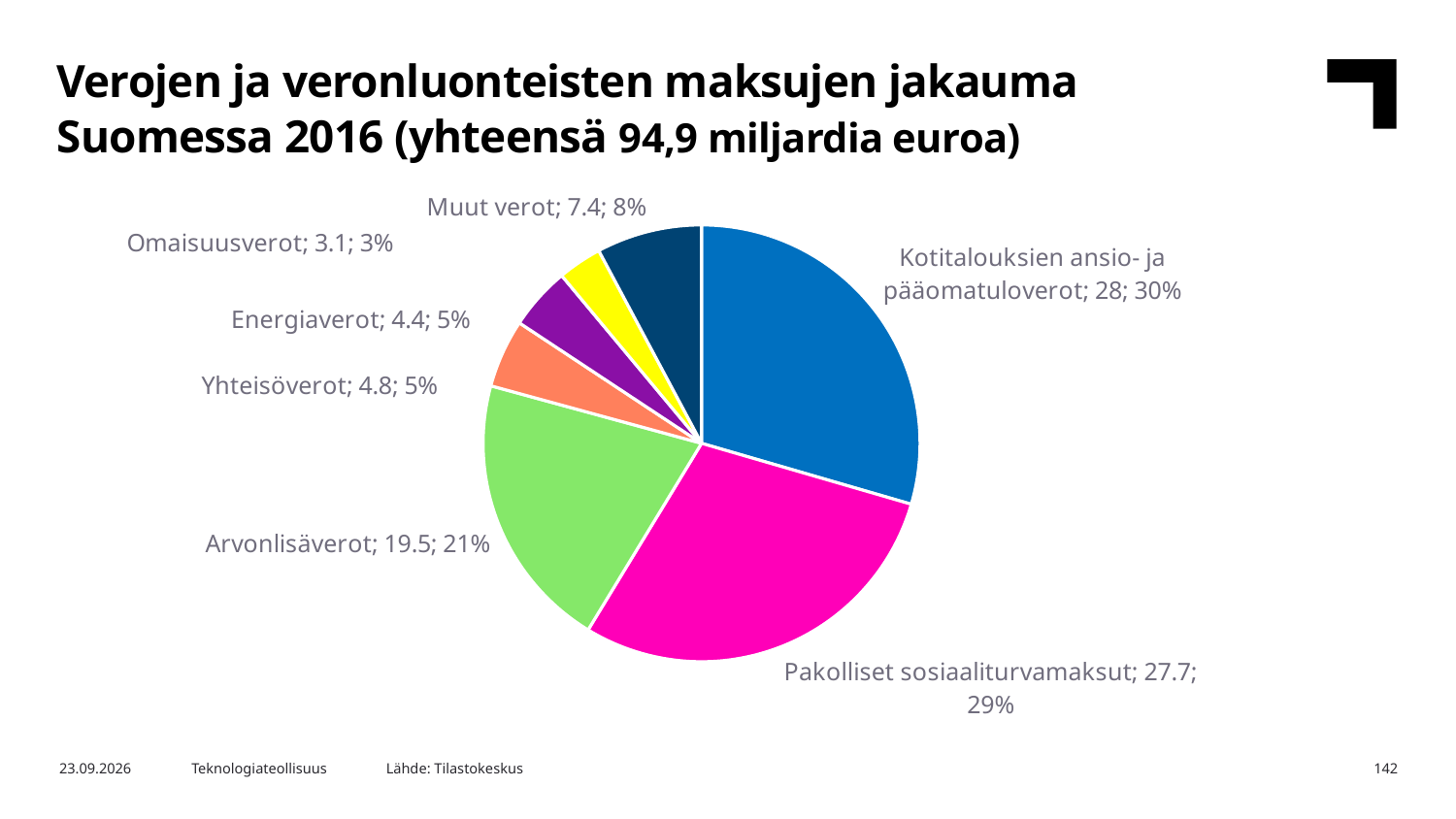
What share of the pie does Arvonlisäverot represent? 21% What value is shown for Arvonlisäverot? 19.5 What is the difference between the values for Arvonlisäverot and Yhteisöverot? 14.7 What is the difference between the values for Muut verot and Energiaverot? 3 What kind of chart is shown on the slide? Pie chart What value is shown for Energiaverot? 4.4 Which category has the smallest slice of the pie? Omaisuusverot What value is shown for Pakolliset sosiaaliturvamaksut? 27.7 Which category has the largest slice of the pie? Kotitalouksien ansio- ja pääomatuloverot What value is shown for Muut verot? 7.4 Which is larger, the value for Yhteisöverot or the value for Omaisuusverot? Yhteisöverot How many slices does the pie chart have? 7